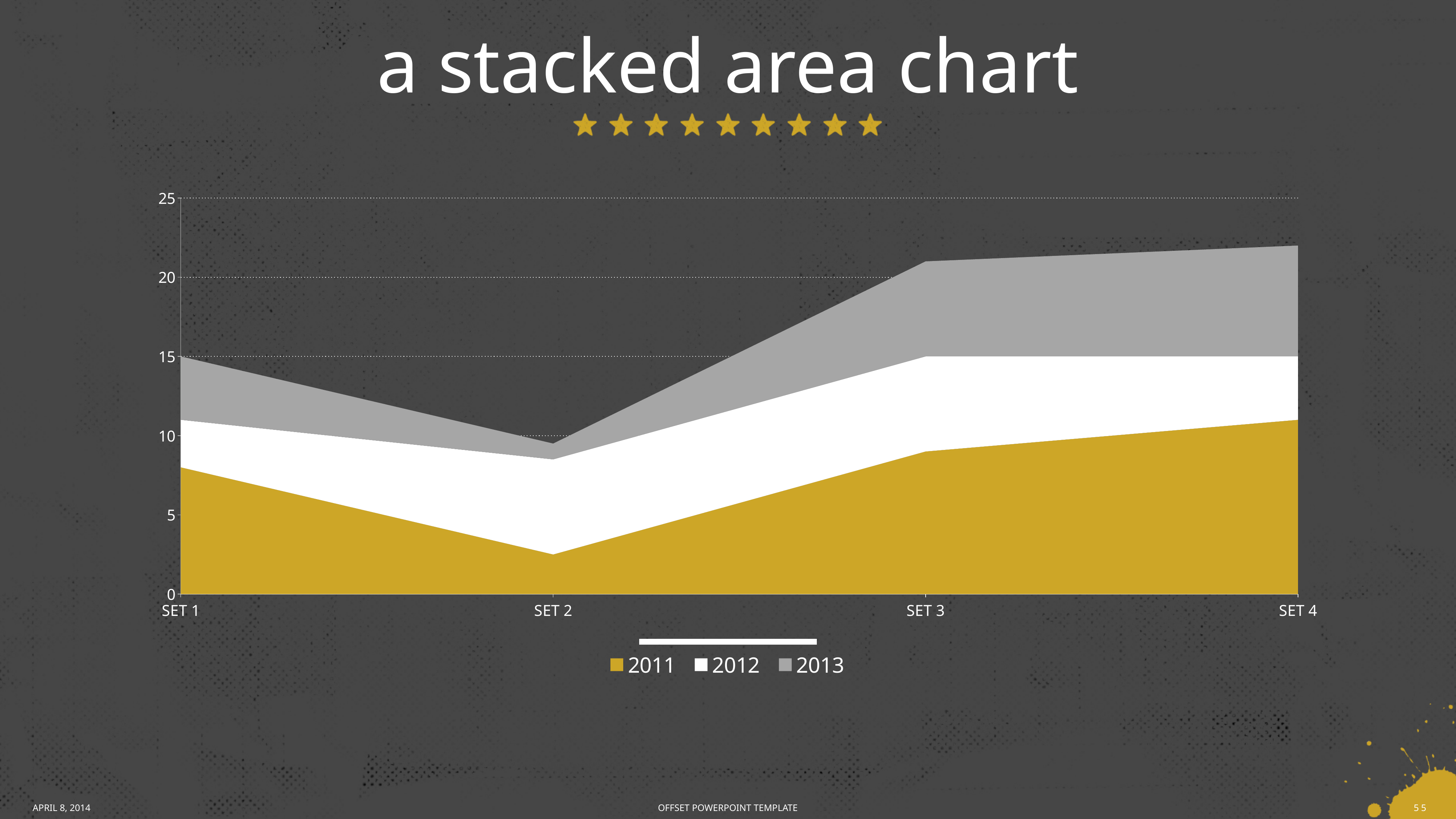
Is the value for 2011 at SET 1 greater or less than 5? greater At which category is the 2011 series highest? SET 4 At which category is the 2011 series lowest? SET 2 Which series is shown in gold/yellow? 2011 What kind of chart is shown on the slide? stacked area chart Does the 2011 series rise or fall from SET 2 to SET 4? rise Is the value for 2011 at SET 4 greater or less than 10? greater How many series does the legend list? 3 How many categories are plotted along the x axis? 4 Is the value for 2011 at SET 2 greater or less than 5? less What are the series names listed in the legend? 2011, 2012, 2013